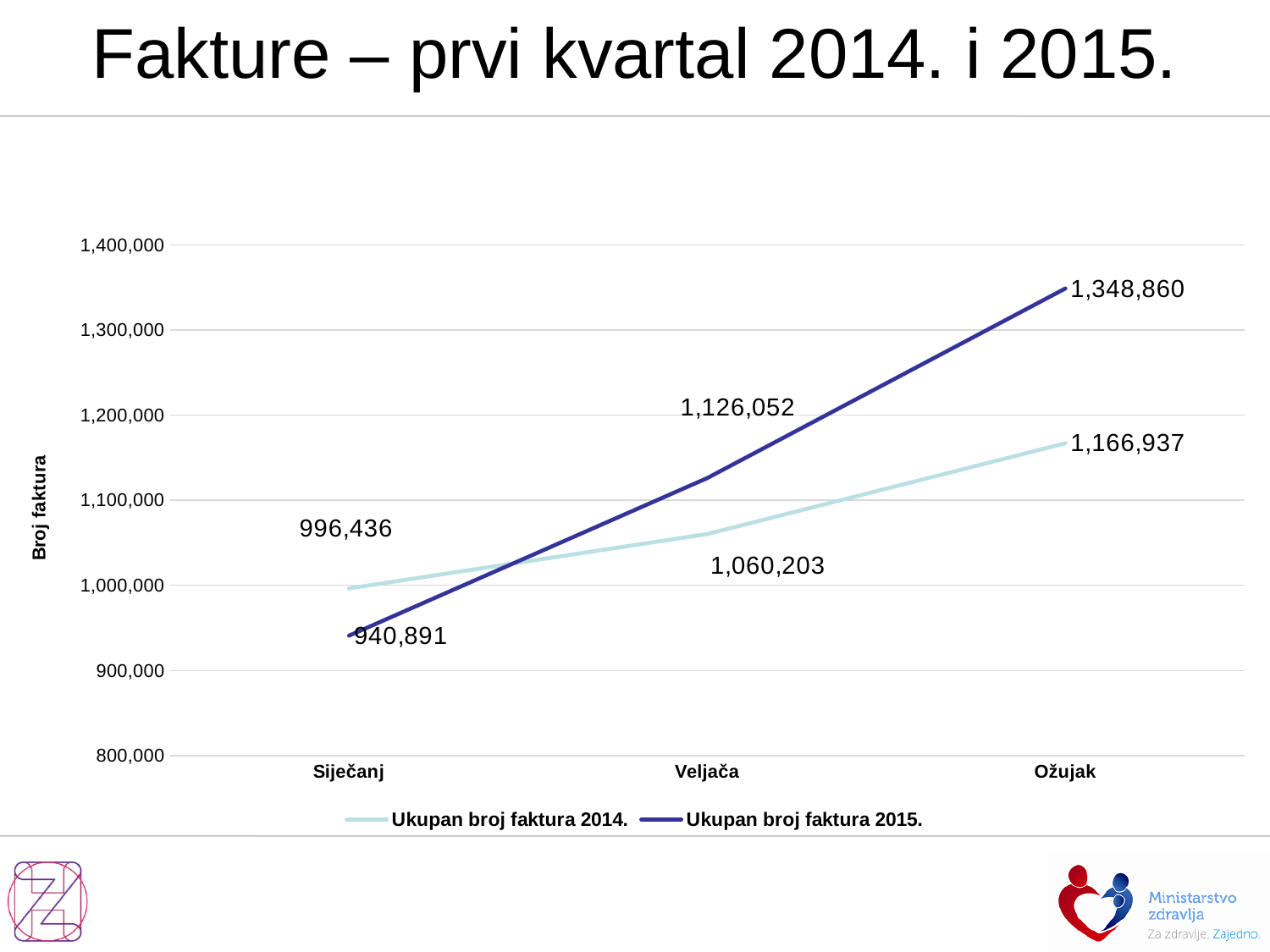
How many months are shown on the x axis? 3 What type of chart is shown on the slide? line chart What is the value for Ukupan broj faktura 2014. in Ožujak? 1,166,937 What is the difference between the 2015 and 2014 values in Ožujak? 181,923 Which series has the larger value in Siječanj, Ukupan broj faktura 2014. or Ukupan broj faktura 2015.? Ukupan broj faktura 2014. In which month is the value for Ukupan broj faktura 2014. highest? Ožujak In which month is the value for Ukupan broj faktura 2015. lowest? Siječanj How many series does the legend list? 2 What is the value for Ukupan broj faktura 2015. in Veljača? 1,126,052 What is the value for Ukupan broj faktura 2015. in Ožujak? 1,348,860 Do the values for Ukupan broj faktura 2015. rise or fall from Siječanj to Ožujak? rise What is the value for Ukupan broj faktura 2014. in Siječanj? 996,436